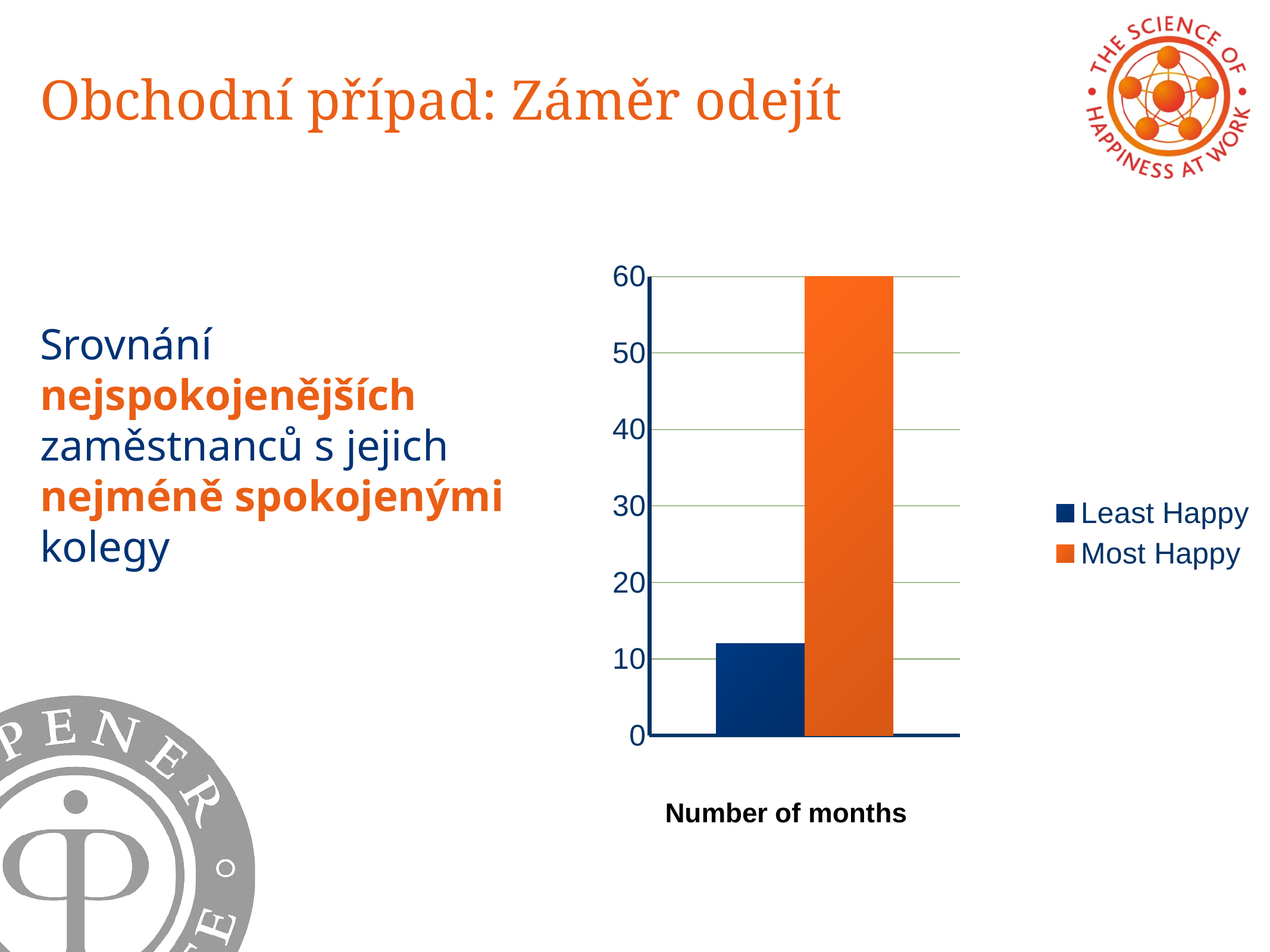
Which series has the higher bar, Least Happy or Most Happy? Most Happy How many series does the chart legend list? 2 Is the value for Most Happy greater or less than 50? greater Is the value for Least Happy greater or less than 10? greater Which series has the shortest bar in the chart? Least Happy What is the label shown under the category axis of the chart? Number of months What is the value of the Most Happy bar? 60 How many categories are shown on the x axis of the chart? 1 Is the value for Least Happy greater or less than 20? less What kind of chart is shown on the slide? bar chart Which series has the tallest bar in the chart? Most Happy What colour is the Most Happy series in the chart? orange